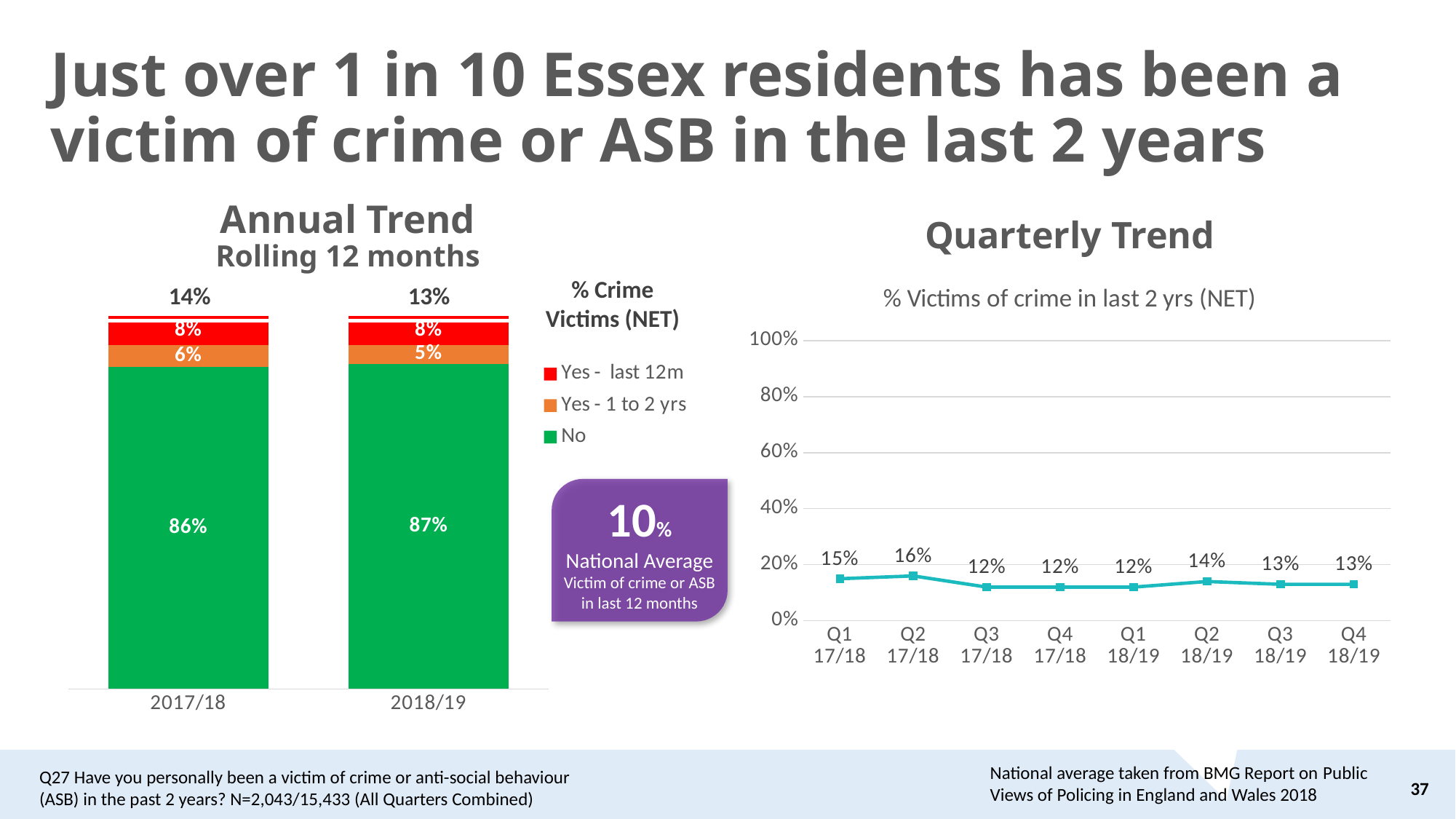
In the Quarterly Trend chart, what is the value for Q2 18/19? 14% In the Annual Trend chart, what is the value for "No" in 2018/19? 87% What kind of chart is the Quarterly Trend chart? Line chart In the Quarterly Trend chart, is the value for Q1 17/18 greater or less than 20%? less In the Annual Trend chart, what is the value for "Yes - last 12m" in 2018/19? 8% In the Annual Trend chart, what is the value for "Yes - 1 to 2 yrs" in 2017/18? 6% In the Quarterly Trend chart, how many quarters are plotted? 8 What kind of chart is the Annual Trend chart? Stacked bar chart In the Quarterly Trend chart, which quarter has the highest value? Q2 17/18 In the Annual Trend chart, how many series does the legend list? 3 In the Quarterly Trend chart, what is the difference between the values for Q2 17/18 and Q3 17/18? 4% In the Annual Trend chart, what is the difference between the "No" values for 2018/19 and 2017/18? 1%